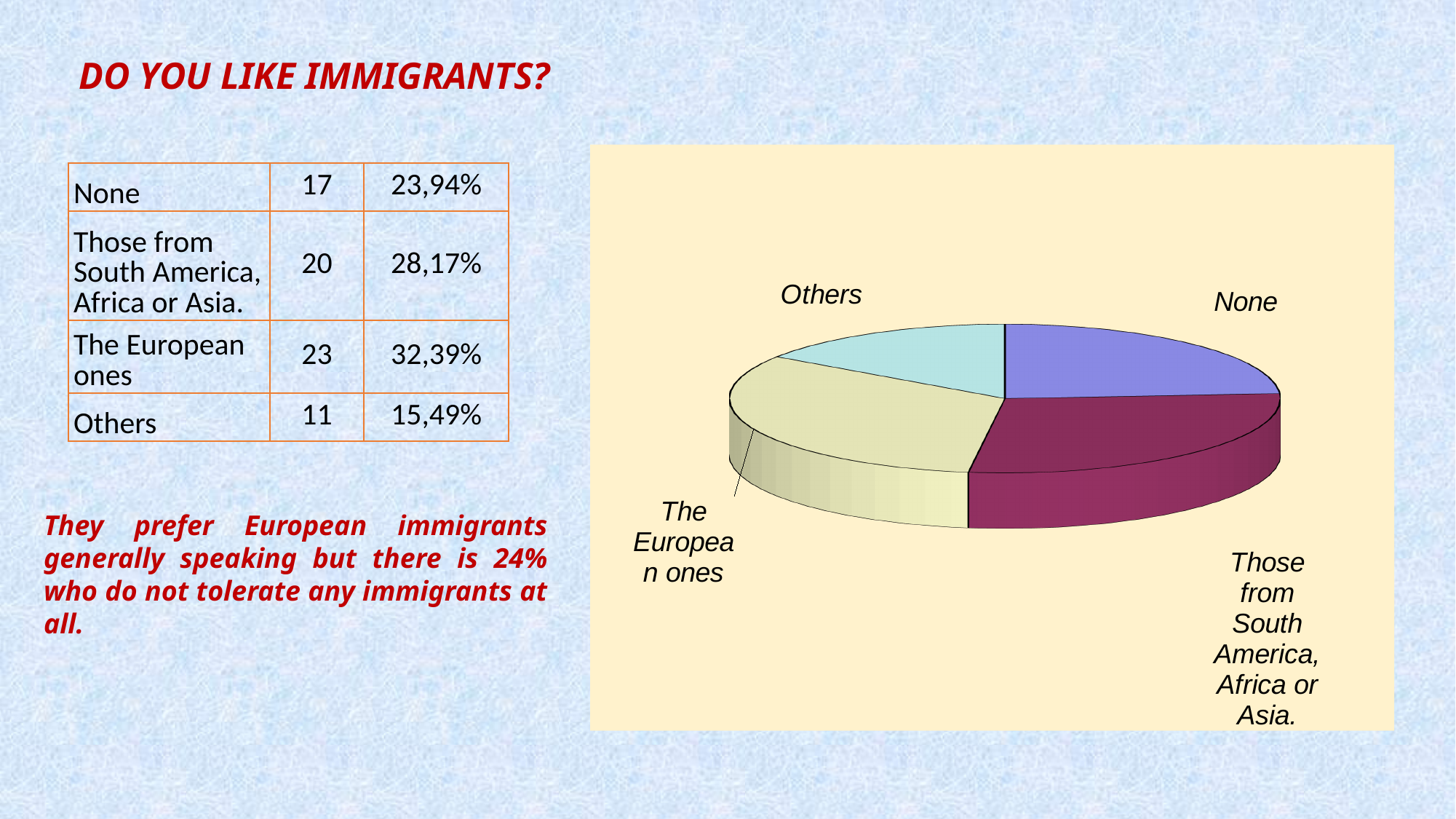
What is the title of the slide containing the pie chart? DO YOU LIKE IMMIGRANTS? According to the table on the slide, what percentage corresponds to "Others"? 15,49% According to the table on the slide, how many respondents chose "Those from South America, Africa or Asia."? 20 According to the table on the slide, what percentage corresponds to "The European ones"? 32,39% What colour is the slice for "None" in the pie chart? Blue According to the table on the slide, how many respondents chose "None"? 17 Is the slice for "None" larger or smaller than the slice for "Those from South America, Africa or Asia."? Smaller Which category has the largest slice of the pie chart? The European ones How many slices does the pie chart have? 4 What is the difference in respondent counts between "The European ones" and "Others" as given in the table? 12 What kind of chart is shown on the slide? Pie chart Which category has the smallest slice of the pie chart? Others